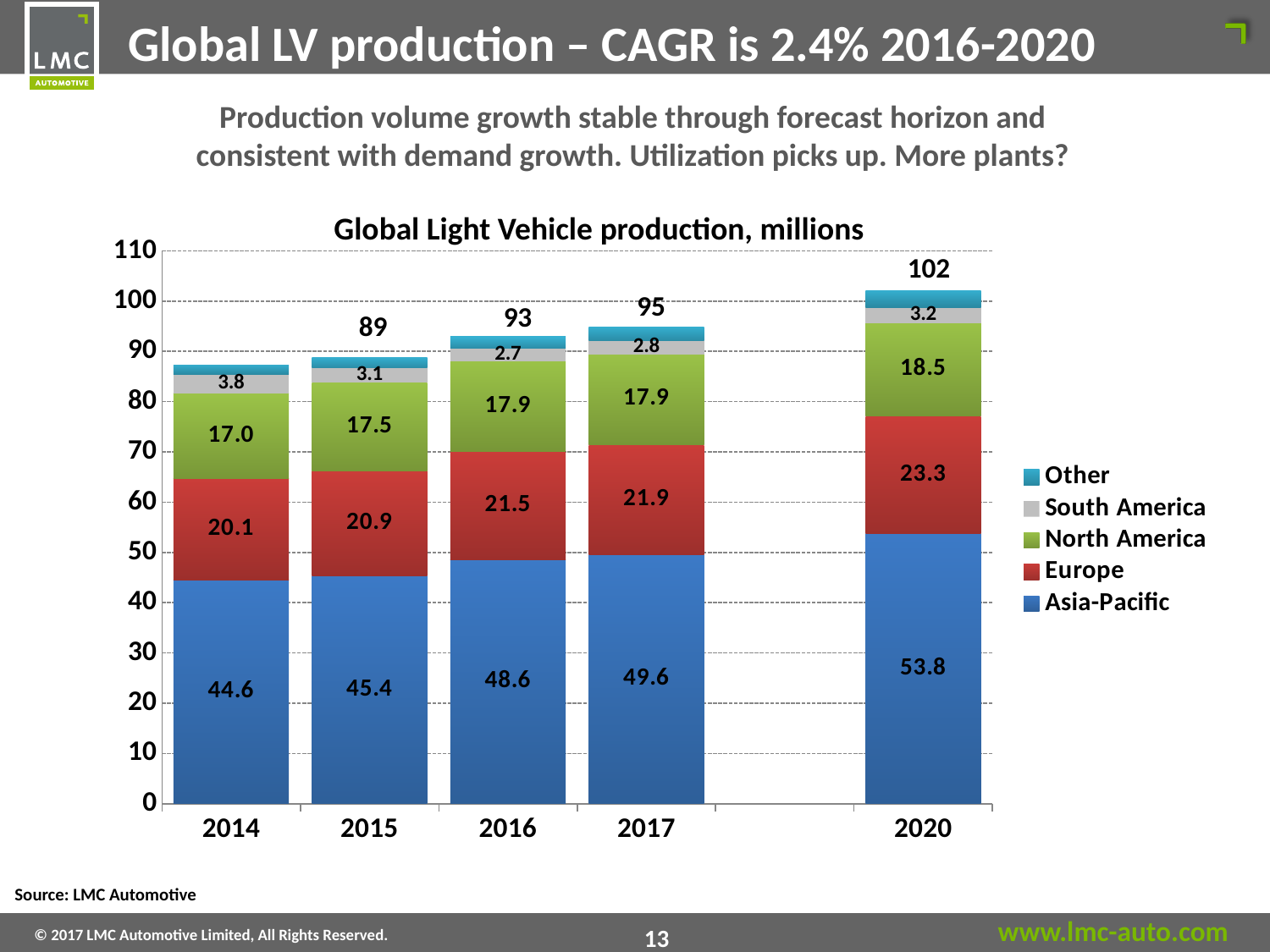
What is the total global light vehicle production shown for 2020? 102 What is the Europe value for 2016? 21.5 Which year has the highest Europe value? 2020 What is the North America value for 2017? 17.9 What is the difference between the total for 2020 and the total for 2015? 13 What is the total global light vehicle production shown for 2015? 89 What is the Asia-Pacific value for 2020? 53.8 What is the South America value for 2014? 3.8 Is the total bar height for 2014 greater or less than 90? less By how much does the Asia-Pacific value in 2020 exceed the Asia-Pacific value in 2014? 9.2 Which year has the lowest South America value? 2016 How many series does the legend list? 5